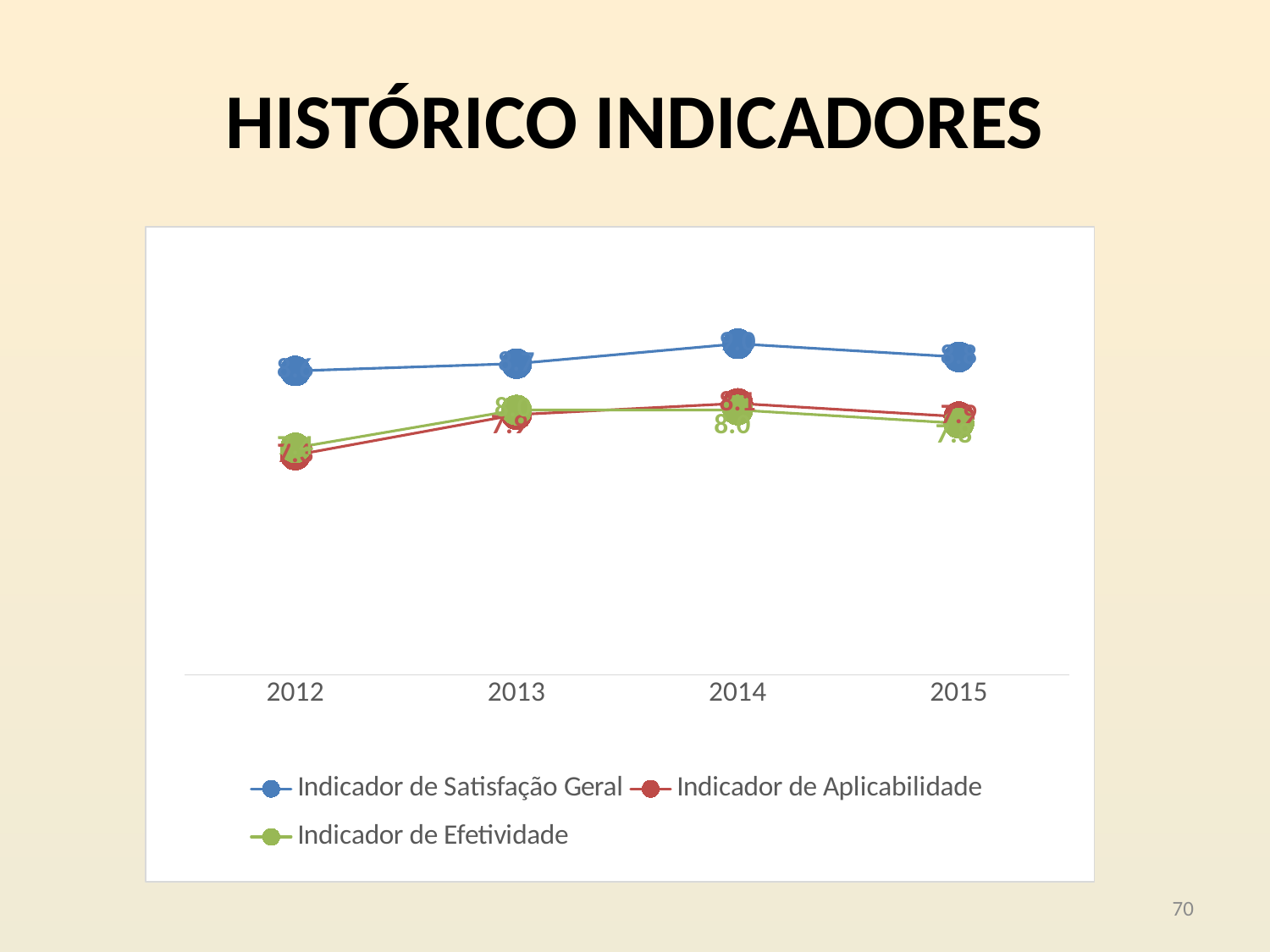
What kind of chart is shown on the slide? line chart Which is larger in 2012, Indicador de Satisfação Geral or Indicador de Aplicabilidade? Indicador de Satisfação Geral Which series has the highest values across all years? Indicador de Satisfação Geral What is the first year shown on the x axis? 2012 How many years are shown on the x axis? 4 In which year is Indicador de Aplicabilidade at its lowest? 2012 Does Indicador de Aplicabilidade rise or fall from 2012 to 2013? rise Which colour represents Indicador de Efetividade in the chart? green Does Indicador de Satisfação Geral rise or fall from 2014 to 2015? fall What is the title of the slide containing the chart? HISTÓRICO INDICADORES How many series does the legend list? 3 In which year does Indicador de Satisfação Geral reach its highest point? 2014